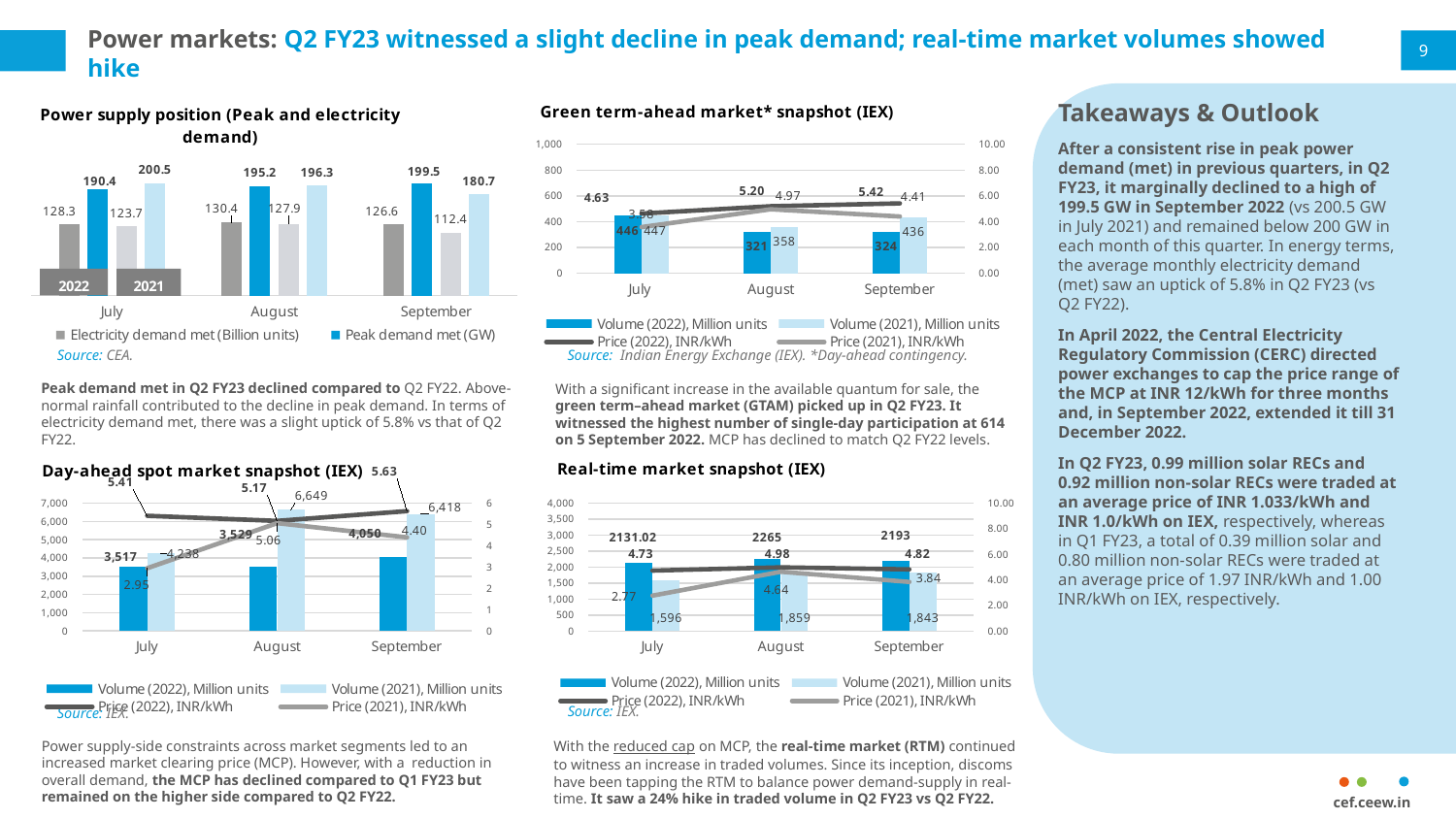
In the 'Real-time market snapshot (IEX)' chart, what is the Price (2021), INR/kWh for July? 2.77 In the 'Power supply position (Peak and electricity demand)' chart, which month has the highest peak demand met (GW) for 2021? July In the 'Day-ahead spot market snapshot (IEX)' chart, which is larger for July: Volume (2022) or Volume (2021)? Volume (2021) In the 'Power supply position (Peak and electricity demand)' chart, what is the peak demand met (GW) for September 2022? 199.5 In the 'Day-ahead spot market snapshot (IEX)' chart, which month has the highest Price (2022), INR/kWh? September In the 'Day-ahead spot market snapshot (IEX)' chart, what is the Volume (2021), Million units for August? 6,649 In the 'Green term-ahead market* snapshot (IEX)' chart, what is the Volume (2022), Million units for July? 446 In the 'Real-time market snapshot (IEX)' chart, how many months are shown on the x axis? 3 In the 'Power supply position (Peak and electricity demand)' chart, what is the difference between peak demand met (GW) in September 2022 and September 2021? 18.8 In the 'Power supply position (Peak and electricity demand)' chart, what is the electricity demand met (Billion units) for August 2021? 127.9 In the 'Green term-ahead market* snapshot (IEX)' chart, how many series does the legend list? 4 In the 'Green term-ahead market* snapshot (IEX)' chart, what is the Price (2021), INR/kWh for August? 4.97